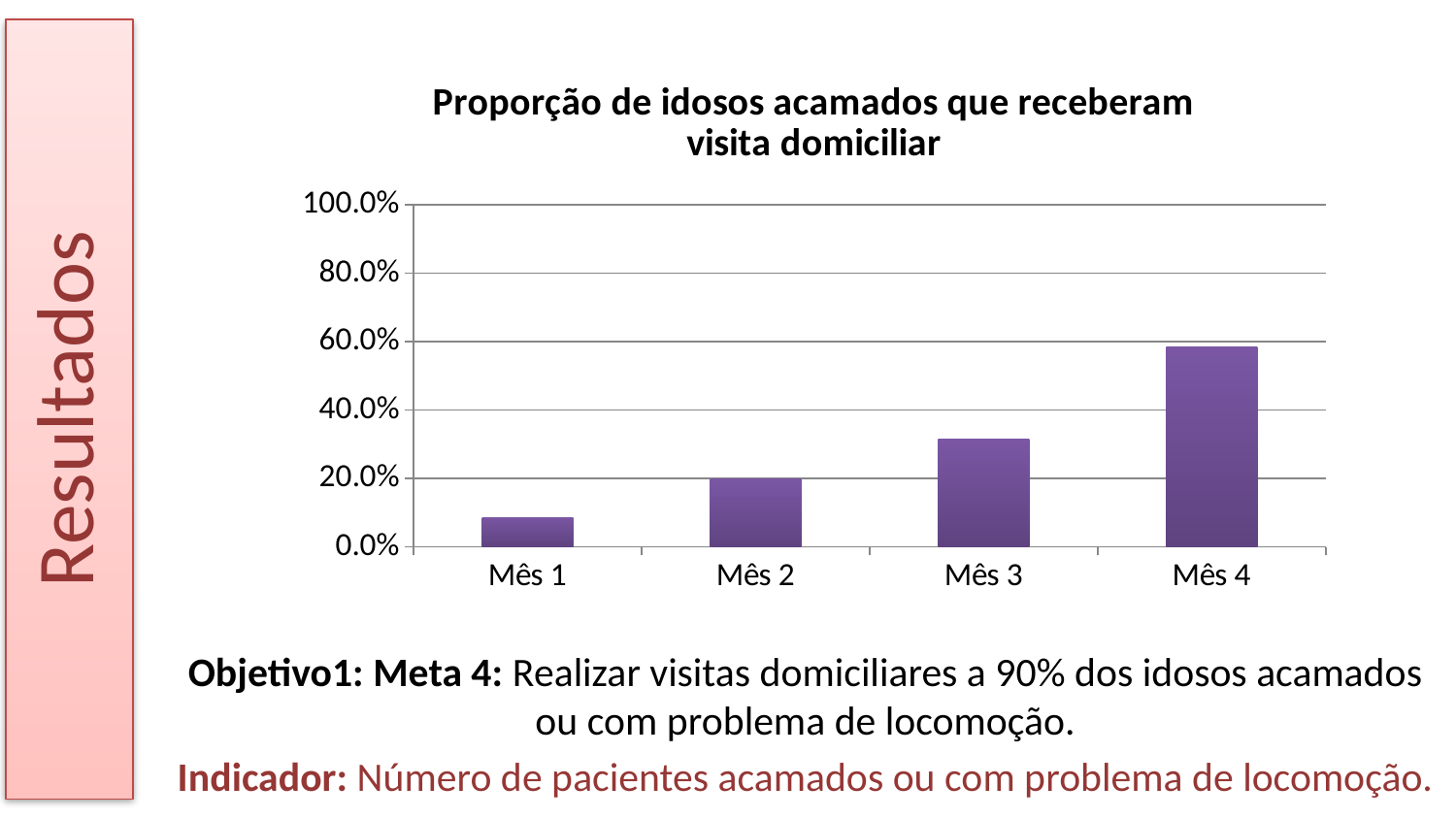
Is the value for Mês 1 greater or less than 20.0%? less What kind of chart is shown on the slide? bar chart Is the value for Mês 4 greater or less than 80.0%? less Which month has the highest proportion of bedridden elderly who received a home visit? Mês 4 Do the values rise or fall from Mês 1 to Mês 4? rise Which is larger, the value for Mês 3 or the value for Mês 2? Mês 3 What is the title of the chart? Proporção de idosos acamados que receberam visita domiciliar Is the value for Mês 4 greater or less than 40.0%? greater How many months (categories) are plotted on the x axis? 4 What is the maximum value shown on the y axis? 100.0% Which month has the lowest proportion? Mês 1